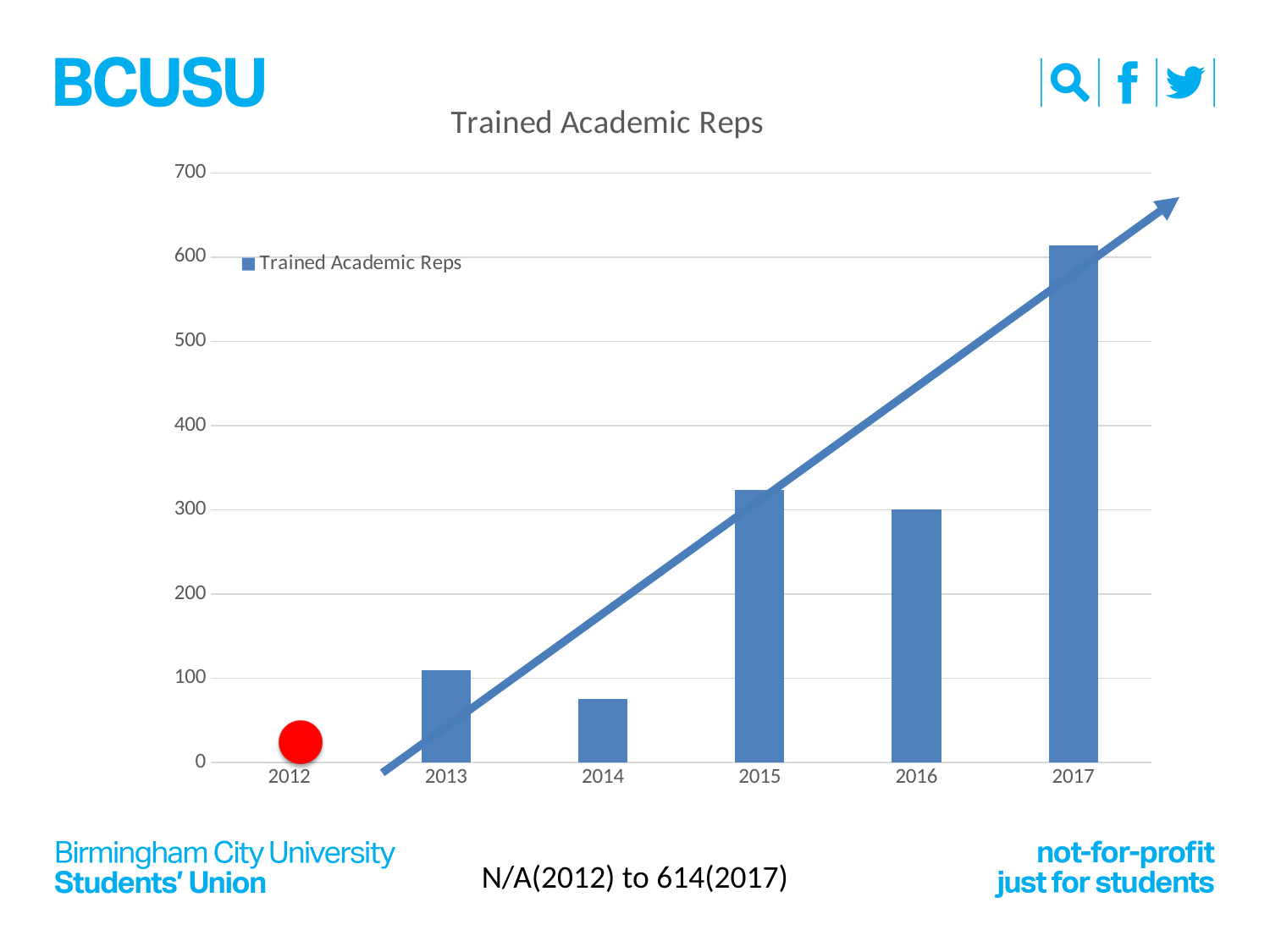
Is the value for 2017 greater or less than 600? greater How many years are shown on the x axis of the chart? 6 Overall, do the values rise or fall from 2013 to 2017? rise According to the text on the slide, how many trained academic reps were there in 2017? 614 What kind of chart is shown on the slide? bar chart How many series does the chart's legend list? 1 Is the value for 2015 greater or less than 300? greater Is the value for 2014 greater or less than 100? less What is the title of the chart? Trained Academic Reps Which year has the highest number of trained academic reps? 2017 Which year has more trained academic reps, 2013 or 2014? 2013 Which year with a bar has the lowest number of trained academic reps? 2014